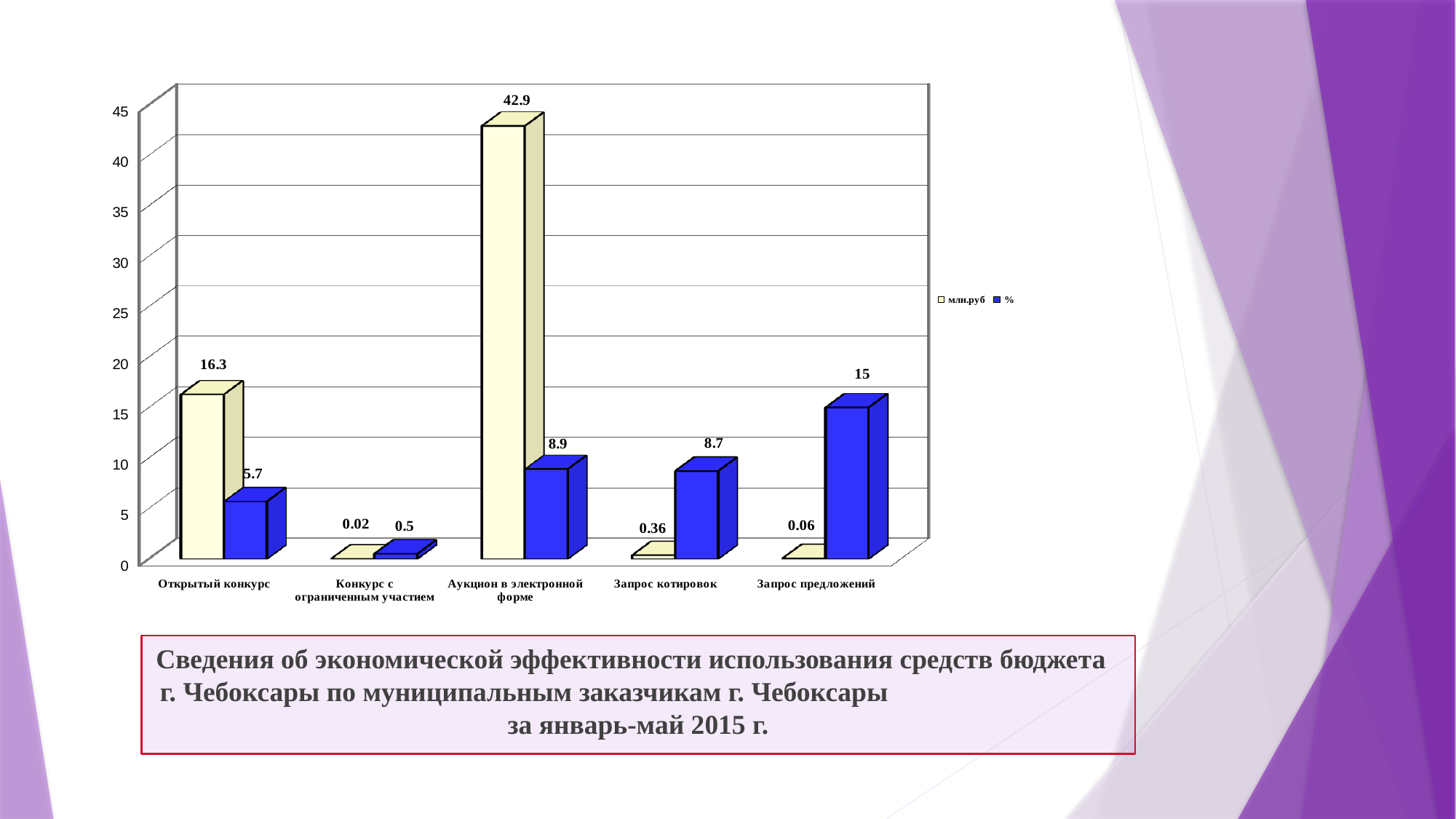
How many series does the legend list? 2 What is the млн.руб value for Аукцион в электронной форме? 42.9 How many categories are shown on the x axis? 5 Which category has the highest % value? Запрос предложений Which category has the highest млн.руб value? Аукцион в электронной форме What is the difference between the млн.руб values for Аукцион в электронной форме and Открытый конкурс? 26.6 What is the % value for Запрос предложений? 15 Which is larger: the % value for Запрос котировок or the % value for Открытый конкурс? Запрос котировок What kind of chart is shown on the slide? Bar chart What is the % value for Конкурс с ограниченным участием? 0.5 Which category has the lowest млн.руб value? Конкурс с ограниченным участием What is the млн.руб value for Открытый конкурс? 16.3